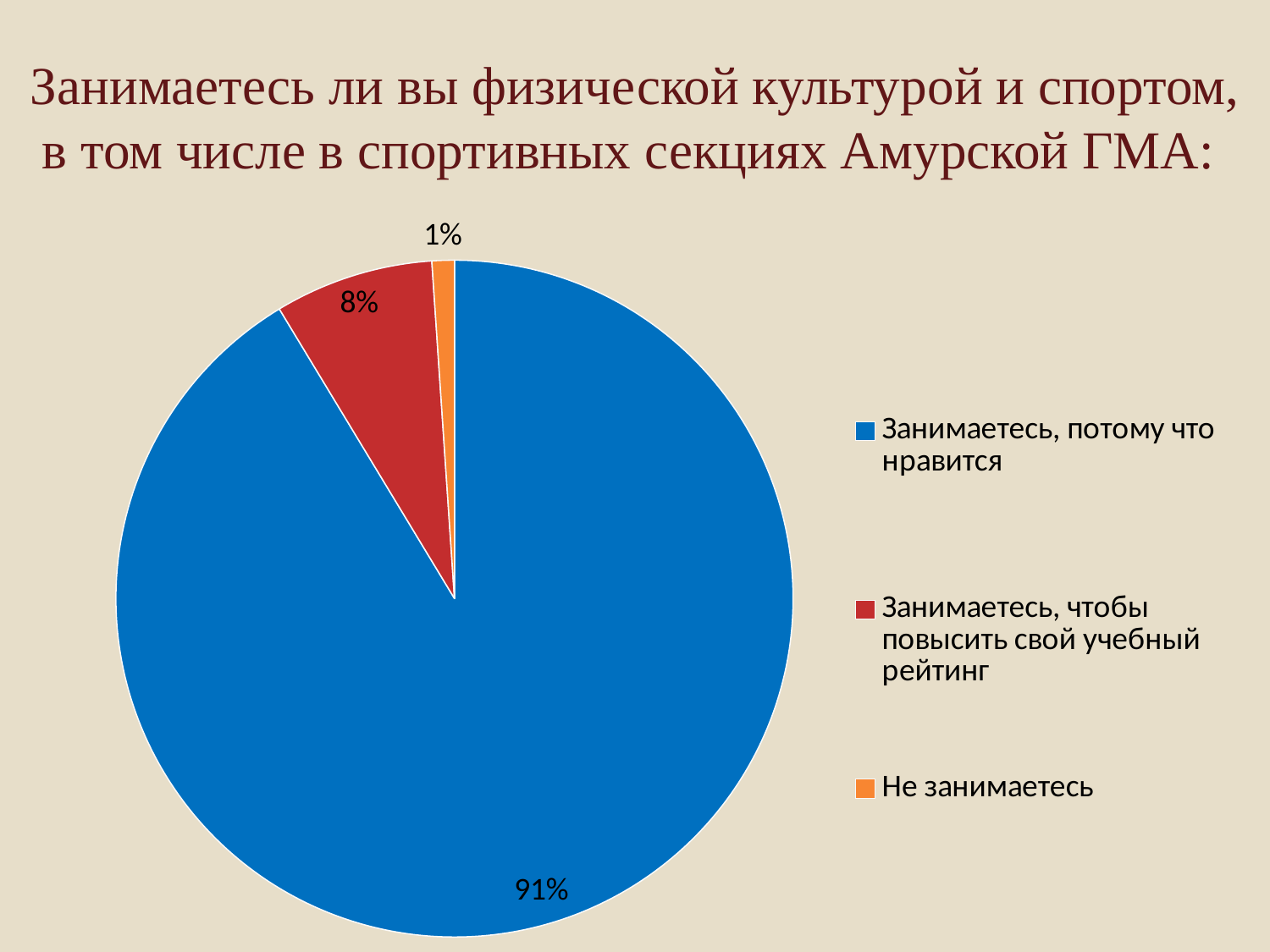
What is the difference between the share for "Занимаетесь, потому что нравится" and the share for "Занимаетесь, чтобы повысить свой учебный рейтинг"? 83% What colour is the slice for "Не занимаетесь"? orange What share of the pie is labelled "Занимаетесь, потому что нравится"? 91% Which category has the smallest slice of the pie? Не занимаетесь What share of the pie is labelled "Занимаетесь, чтобы повысить свой учебный рейтинг"? 8% What share of the pie is labelled "Не занимаетесь"? 1% What type of chart is shown on the slide? pie chart What is the difference between the share for "Занимаетесь, чтобы повысить свой учебный рейтинг" and the share for "Не занимаетесь"? 7% Which is larger: the share for "Занимаетесь, чтобы повысить свой учебный рейтинг" or the share for "Не занимаетесь"? Занимаетесь, чтобы повысить свой учебный рейтинг How many categories does the pie chart have? 3 What colour is the slice for "Занимаетесь, потому что нравится"? blue Which category has the largest slice of the pie? Занимаетесь, потому что нравится